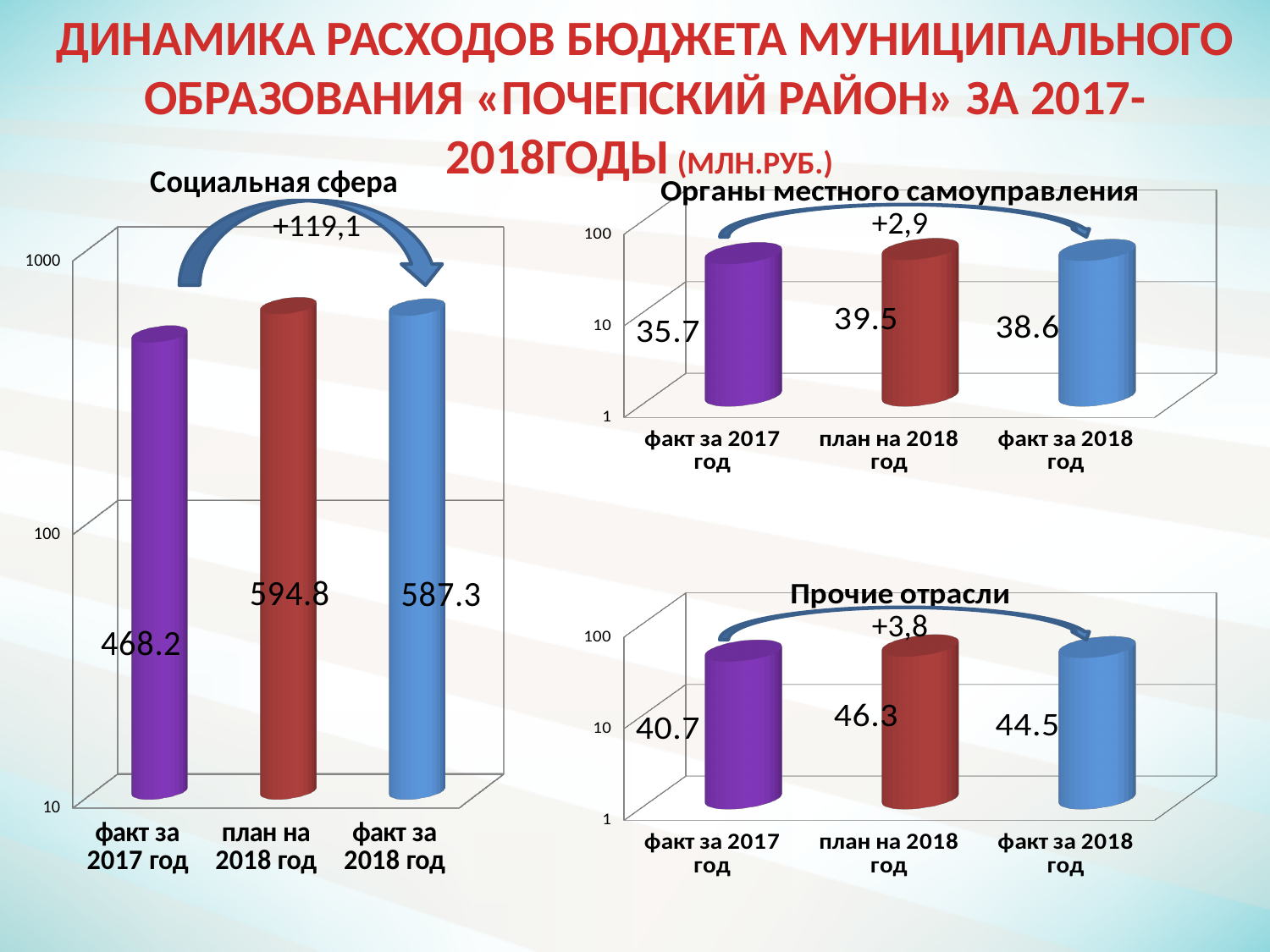
In the "Социальная сфера" chart, what is the value for "факт за 2017 год"? 468.2 In the "Социальная сфера" chart, what is the difference between "факт за 2018 год" and "факт за 2017 год"? 119.1 In the "Прочие отрасли" chart, which is larger: "факт за 2017 год" or "факт за 2018 год"? факт за 2018 год In the "Органы местного самоуправления" chart, what is the value for "факт за 2018 год"? 38.6 In the "Социальная сфера" chart, which category has the highest value? план на 2018 год In the "Прочие отрасли" chart, what is the value for "план на 2018 год"? 46.3 In the "Социальная сфера" chart, what is the value for "план на 2018 год"? 594.8 How many categories are shown in the "Прочие отрасли" chart? 3 What kind of chart is the "Социальная сфера" chart? bar chart In the "Прочие отрасли" chart, what is the difference between "факт за 2018 год" and "факт за 2017 год"? 3.8 In the "Органы местного самоуправления" chart, what is the difference between "план на 2018 год" and "факт за 2018 год"? 0.9 In the "Органы местного самоуправления" chart, which category has the lowest value? факт за 2017 год